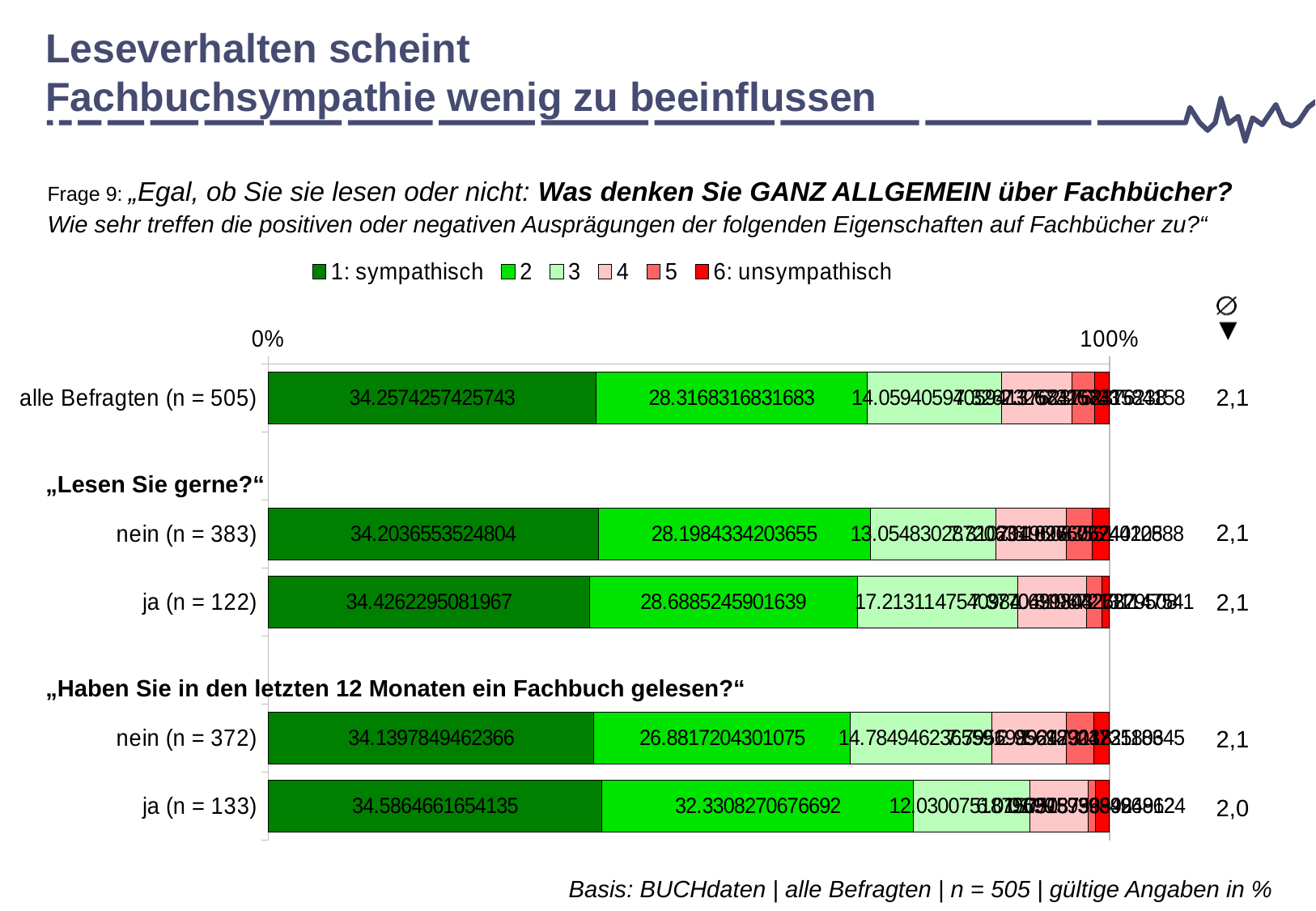
What kind of chart is shown on the slide? Stacked bar chart What is the value of the '2' segment for 'nein (n = 372)' under 'Haben Sie in den letzten 12 Monaten ein Fachbuch gelesen?'? 26.8817204301075 Which has a larger '1: sympathisch' value: 'ja (n = 122)' or 'ja (n = 133)'? ja (n = 133) Which bar has the highest value for the '2' segment? ja (n = 133) What is the Ø (mean) value shown for 'ja (n = 133)'? 2,0 How many bars are shown in the chart? 5 What is the difference between the '2' segment values of 'ja (n = 133)' and 'nein (n = 372)'? 5.4491066375617 Which bar has the lowest value for the '2' segment? nein (n = 372) What is the value of the '2' segment for 'ja (n = 133)' under 'Haben Sie in den letzten 12 Monaten ein Fachbuch gelesen?'? 32.3308270676692 What is the value of the '1: sympathisch' segment for 'alle Befragten (n = 505)'? 34.2574257425743 How many series does the legend list? 6 What is the value of the '1: sympathisch' segment for 'nein (n = 383)' under 'Lesen Sie gerne?'? 34.2036553524804